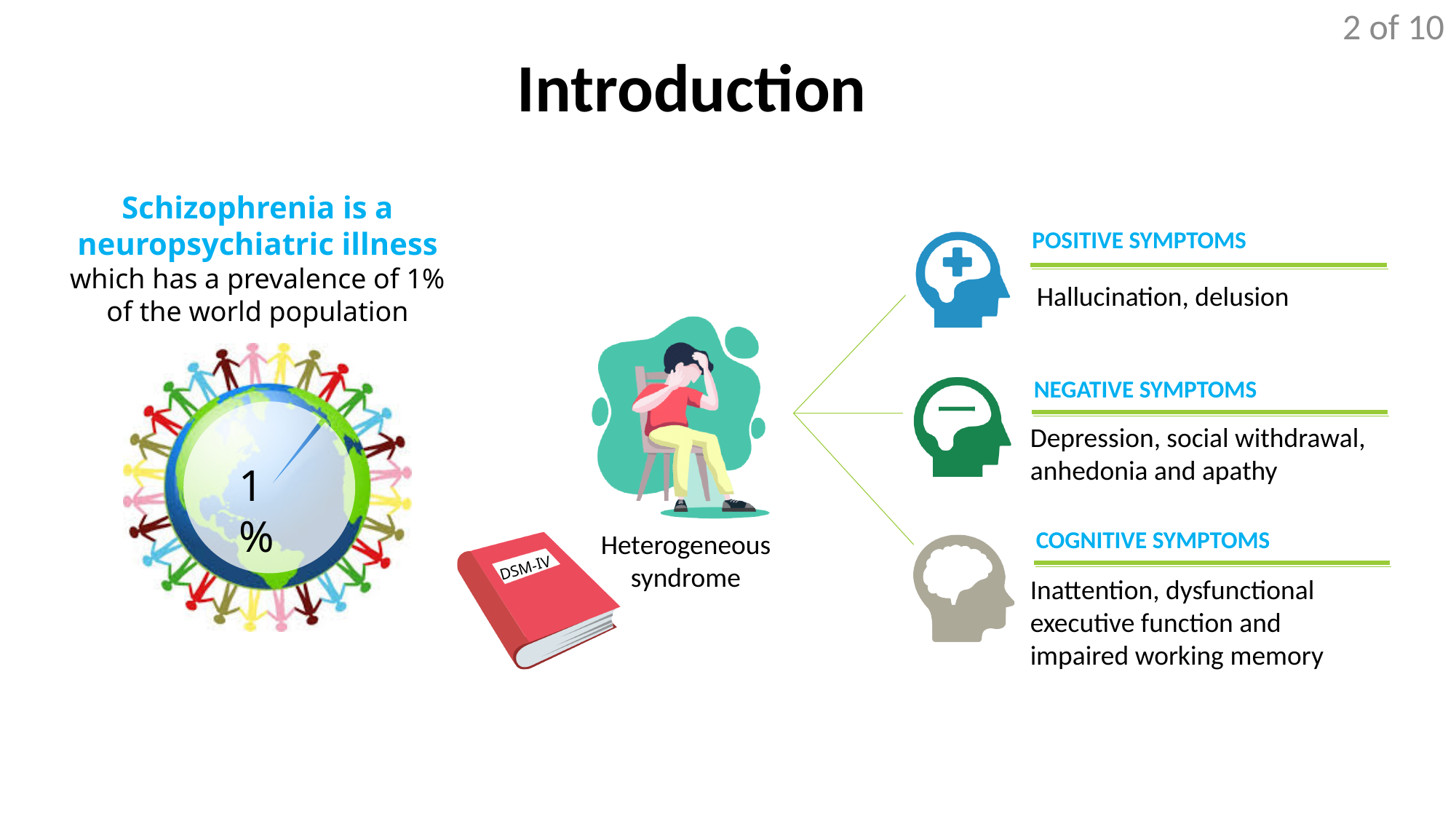
What value is printed on the labelled slice of the pie chart on the left of the slide? 1% What kind of chart is overlaid on the globe on the left of the slide? pie chart Is the labelled slice of the pie chart on the left of the slide greater or less than 50% of the pie? less Which is larger in the pie chart on the left of the slide: the labelled 1% slice or the unlabelled remainder? the unlabelled remainder According to the text above the pie chart, what does the 1% slice represent? prevalence of schizophrenia in the world population What share of the pie chart on the left of the slide does the labelled slice represent? 1% How many slices of the pie chart on the left of the slide carry a printed data label? 1